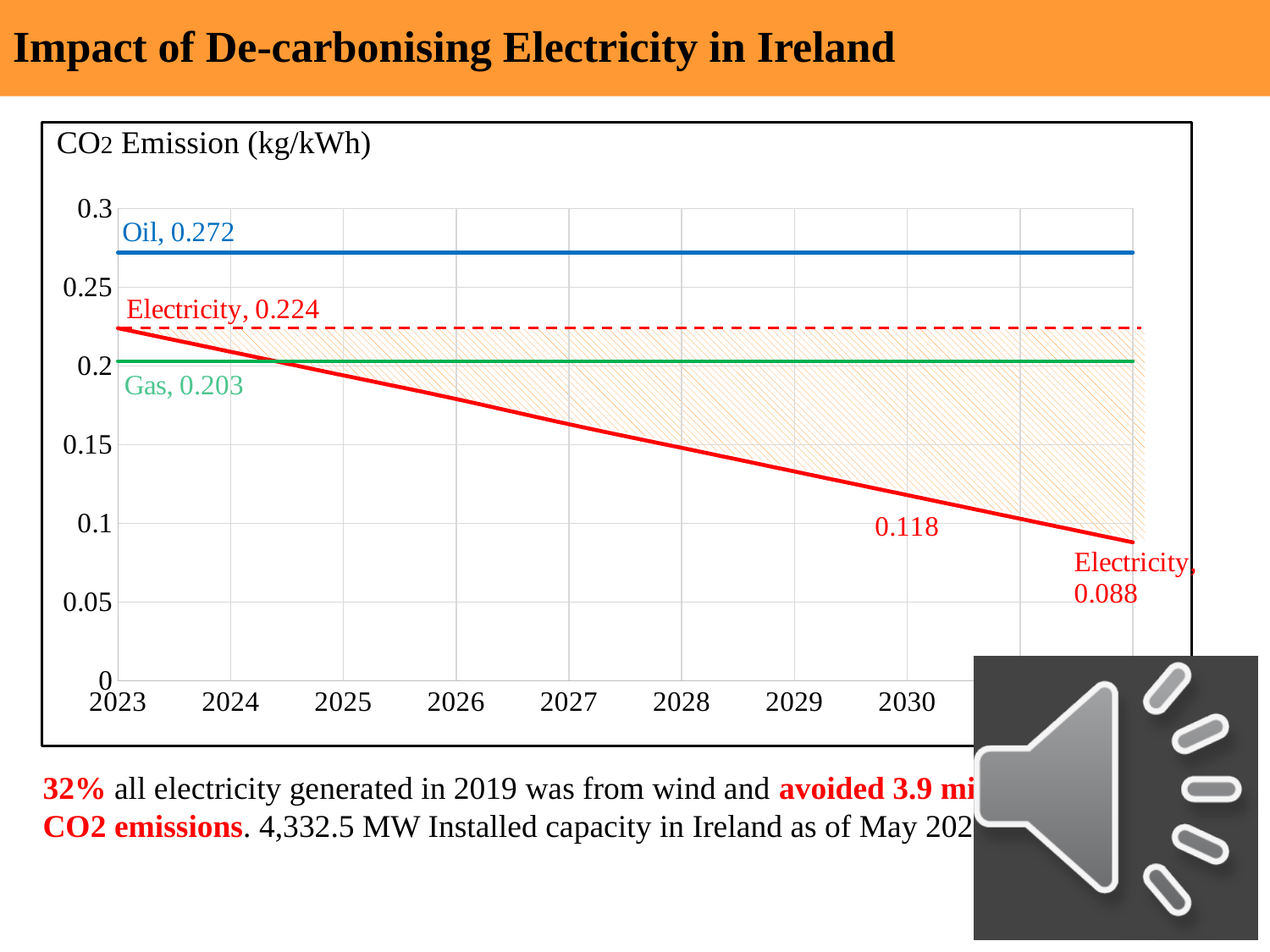
Which has the higher CO2 emission value, Oil or Gas? Oil What is the CO2 emission value shown for Gas? 0.203 Which fuel has the highest CO2 emission value on the chart? Oil What is the CO2 emission value labelled for Electricity at the start of the chart (2023)? 0.224 What kind of chart is shown on the slide? line chart Is the value of the solid Electricity line in 2027 greater or less than 0.2? less What is the CO2 emission value labelled for Electricity at the end of the declining line? 0.088 Does the solid Electricity line rise or fall from 2023 onwards? fall By how much does the Electricity value fall from its starting label of 0.224 to its final label of 0.088? 0.136 What is the title shown at the top of the chart? CO2 Emission (kg/kWh) What is the CO2 emission value shown for Oil? 0.272 What is the difference between the Oil value (0.272) and the Gas value (0.203)? 0.069